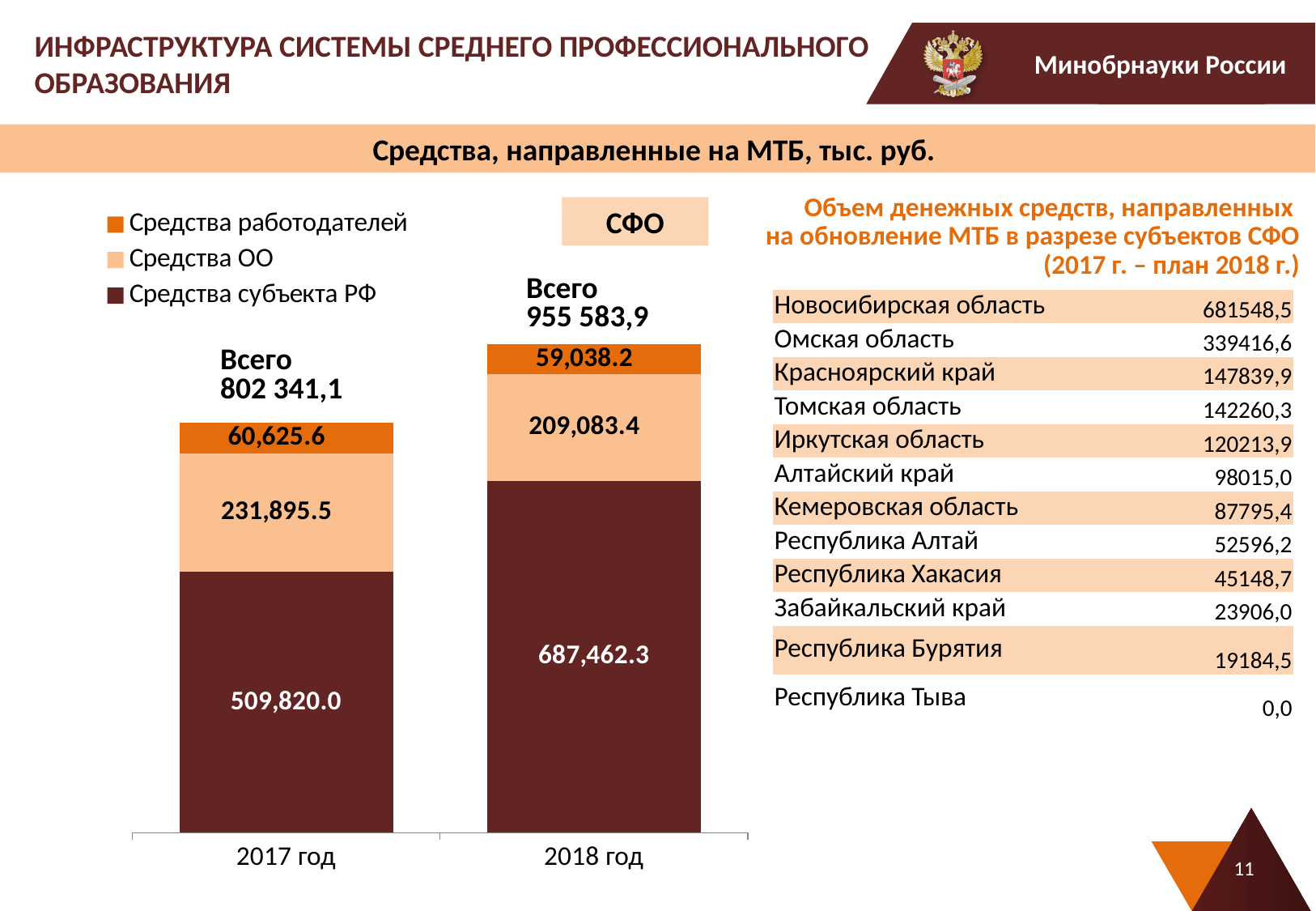
What is the total (Всего) for the 2017 год bar? 802 341,1 What is the value of Средства работодателей for 2018 год? 59,038.2 How many categories are shown on the x axis of the chart? 2 What is the value of Средства ОО for 2018 год? 209,083.4 Which series is shown in the darkest colour in the chart? Средства субъекта РФ What is the difference between Средства ОО in 2017 год and 2018 год? 22,812.1 What is the total (Всего) for the 2018 год bar? 955 583,9 What is the value of Средства работодателей for 2017 год? 60,625.6 How many series does the chart legend list? 3 What kind of chart is shown on the slide? Stacked bar chart What is the value of Средства субъекта РФ for 2017 год? 509,820.0 Which year has the larger value for Средства субъекта РФ, 2017 год or 2018 год? 2018 год